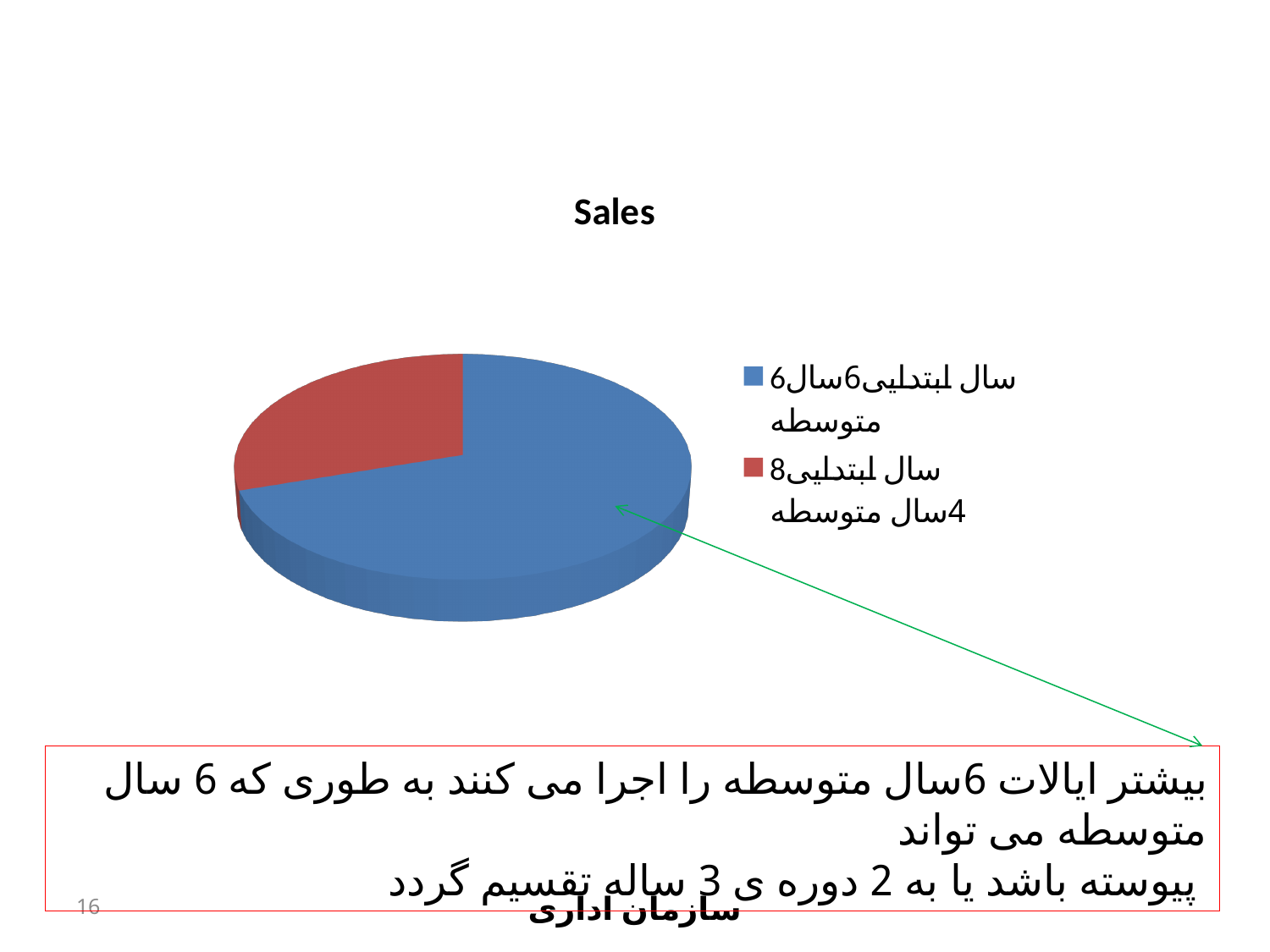
What kind of chart is shown on the slide? pie chart What is the title of the chart? Sales Which category has the largest slice of the pie? 6سال ابتدایی 6سال متوسطه How many slices does the pie chart have? 2 How many entries does the legend list? 2 Which slice is larger: '6سال ابتدایی 6سال متوسطه' or '8سال ابتدایی 4سال متوسطه'? 6سال ابتدایی 6سال متوسطه What colour is the slice for '8سال ابتدایی 4سال متوسطه'? red Which category has the smallest slice of the pie? 8سال ابتدایی 4سال متوسطه